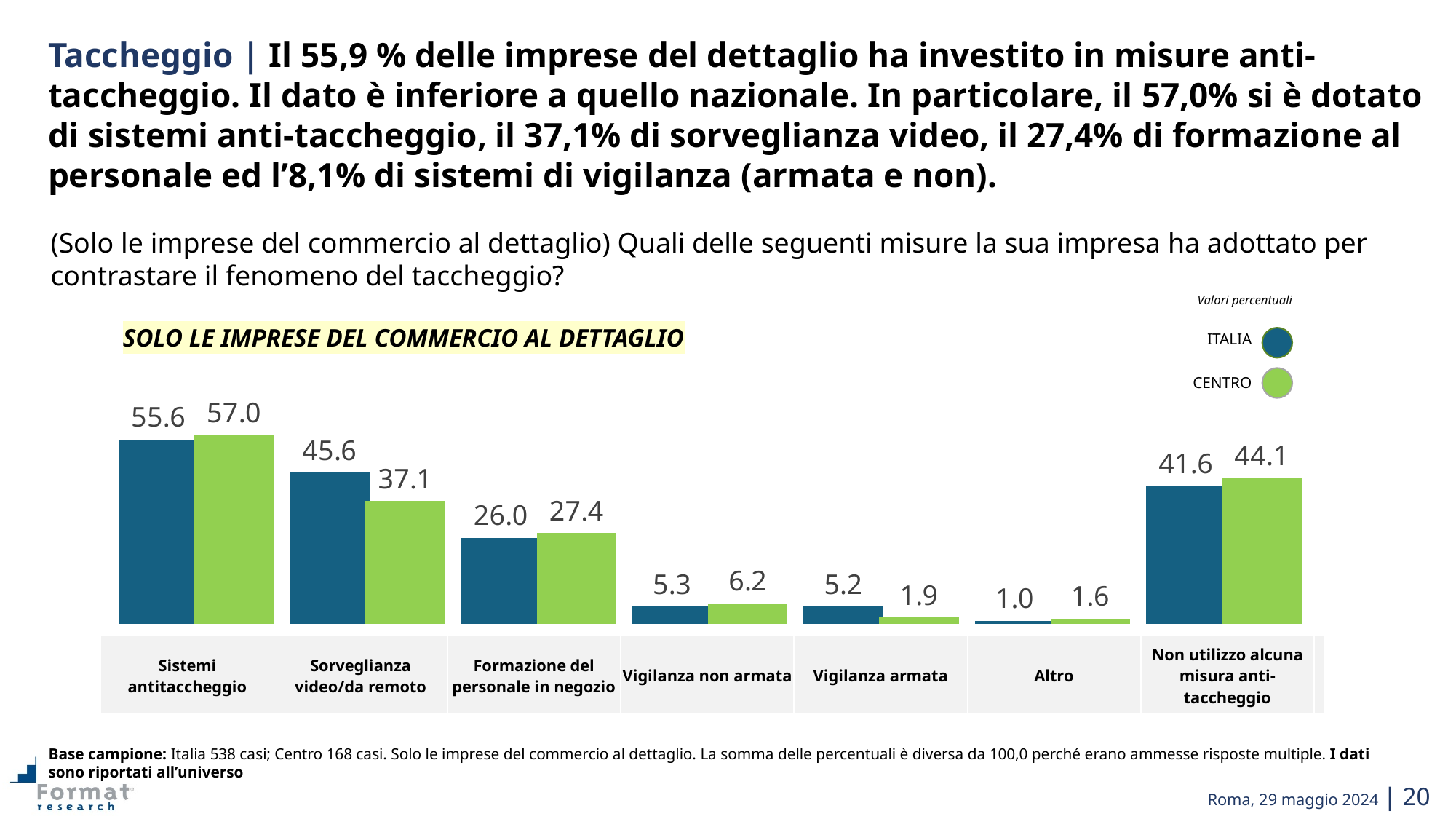
What is the CENTRO value for Vigilanza armata? 1.9 How many series does the legend list? 2 What is the ITALIA value for Sorveglianza video/da remoto? 45.6 Which colour represents the ITALIA series in the legend? Dark blue Which is larger for Vigilanza non armata, the ITALIA value or the CENTRO value? CENTRO How many categories are shown on the x axis? 7 What is the difference between the CENTRO and ITALIA values for Non utilizzo alcuna misura anti-taccheggio? 2.5 What kind of chart is shown on the slide? Bar chart What is the CENTRO value for Sistemi antitaccheggio? 57.0 Which category has the lowest CENTRO value? Altro What is the difference between the ITALIA and CENTRO values for Sorveglianza video/da remoto? 8.5 Which category has the highest ITALIA value? Sistemi antitaccheggio